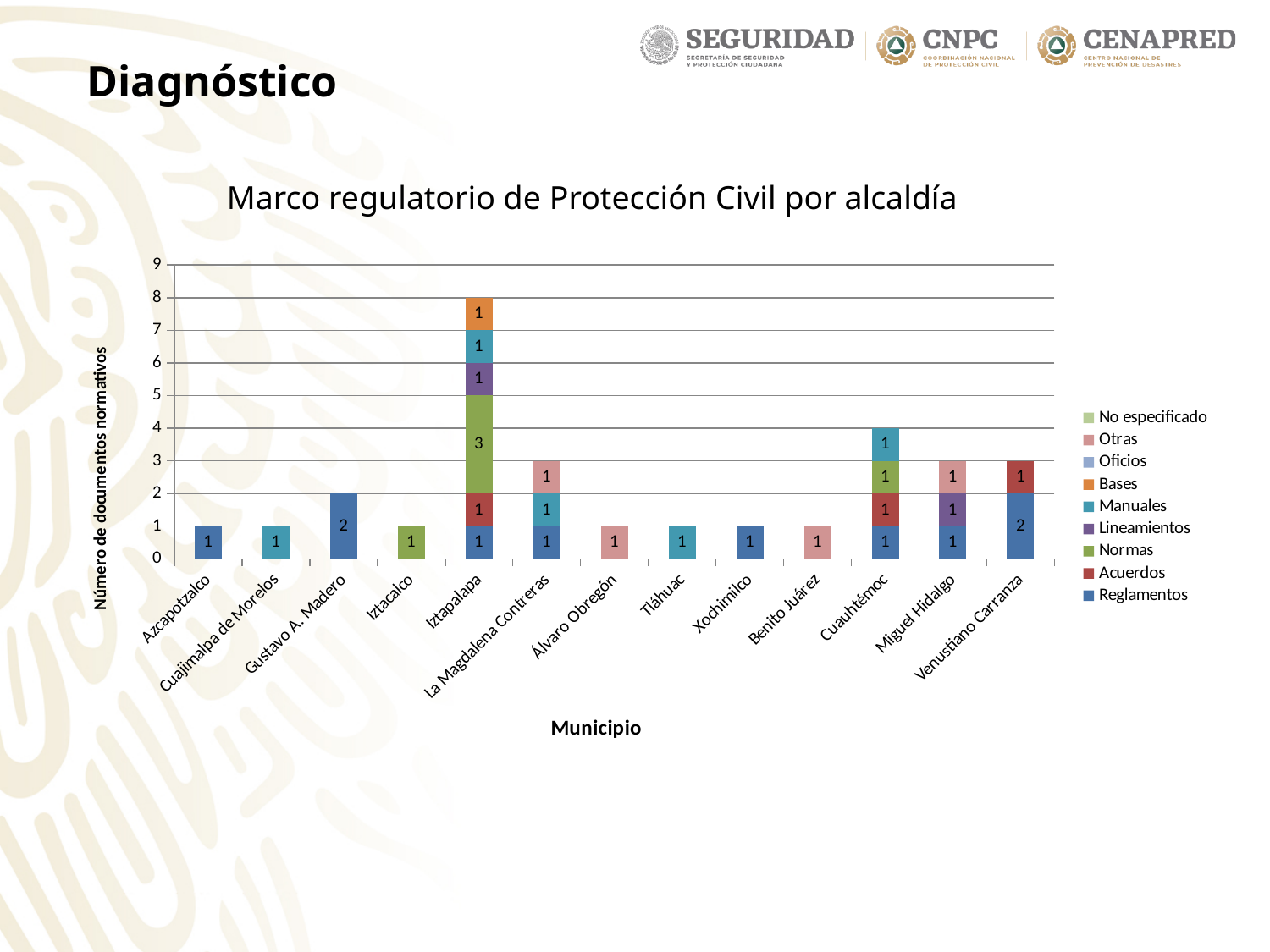
How many series does the legend list? 9 Which has a larger total, Miguel Hidalgo or Gustavo A. Madero? Miguel Hidalgo What is the value of Reglamentos for Venustiano Carranza? 2 How many municipalities are shown on the x axis of the chart? 13 What type of chart is shown on the slide? Stacked bar chart What is the title of the chart? Marco regulatorio de Protección Civil por alcaldía What is the total of the stacked bar for Cuauhtémoc? 4 What is the total of the stacked bar for Iztapalapa? 8 What is the value of Reglamentos for Gustavo A. Madero? 2 What is the difference between the total for Iztapalapa and the total for Cuauhtémoc? 4 What is the value of Normas for Iztapalapa? 3 Which municipality has the highest total number of normative documents? Iztapalapa